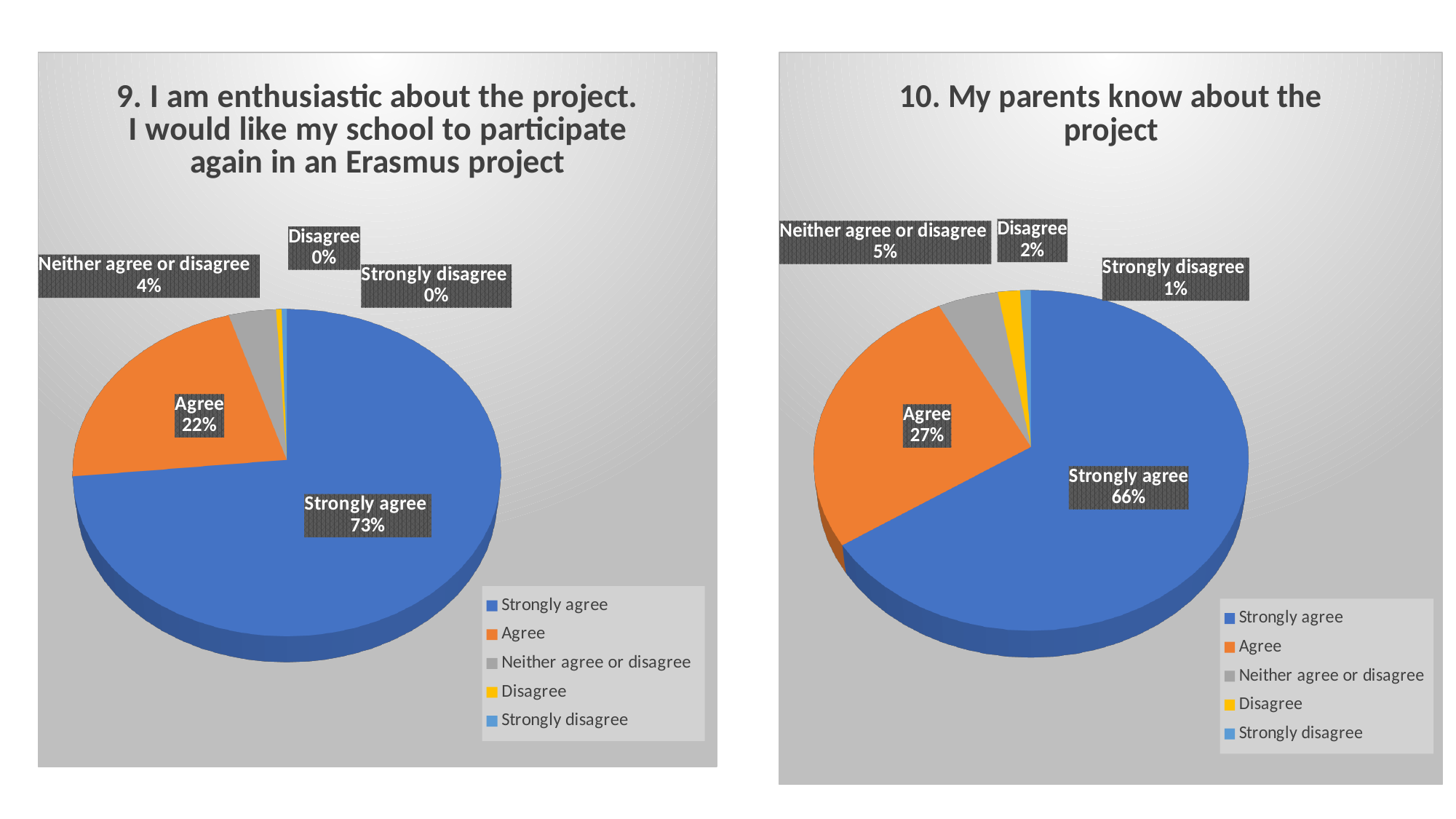
In the left chart (question 9), which response has the largest share? Strongly agree In the right chart (question 10), what is the difference in percentage points between Agree and Neither agree or disagree? 22 Which chart has the larger share for Strongly agree, the left chart (question 9) or the right chart (question 10)? The left chart (question 9) In the right chart (question 10), what percentage of respondents chose Strongly disagree? 1% What type of chart is used on the slide? Pie chart In the left chart (question 9), what percentage of respondents chose Strongly agree? 73% In the right chart (question 10), what percentage of respondents chose Neither agree or disagree? 5% In the left chart (question 9), what percentage of respondents chose Agree? 22% In the left chart (question 9), what is the difference in percentage points between Strongly agree and Agree? 51 In the right chart (question 10), what percentage of respondents chose Strongly agree? 66% How many entries does the legend of the right chart (question 10) list? 5 In the right chart (question 10), which response has the smallest share? Strongly disagree